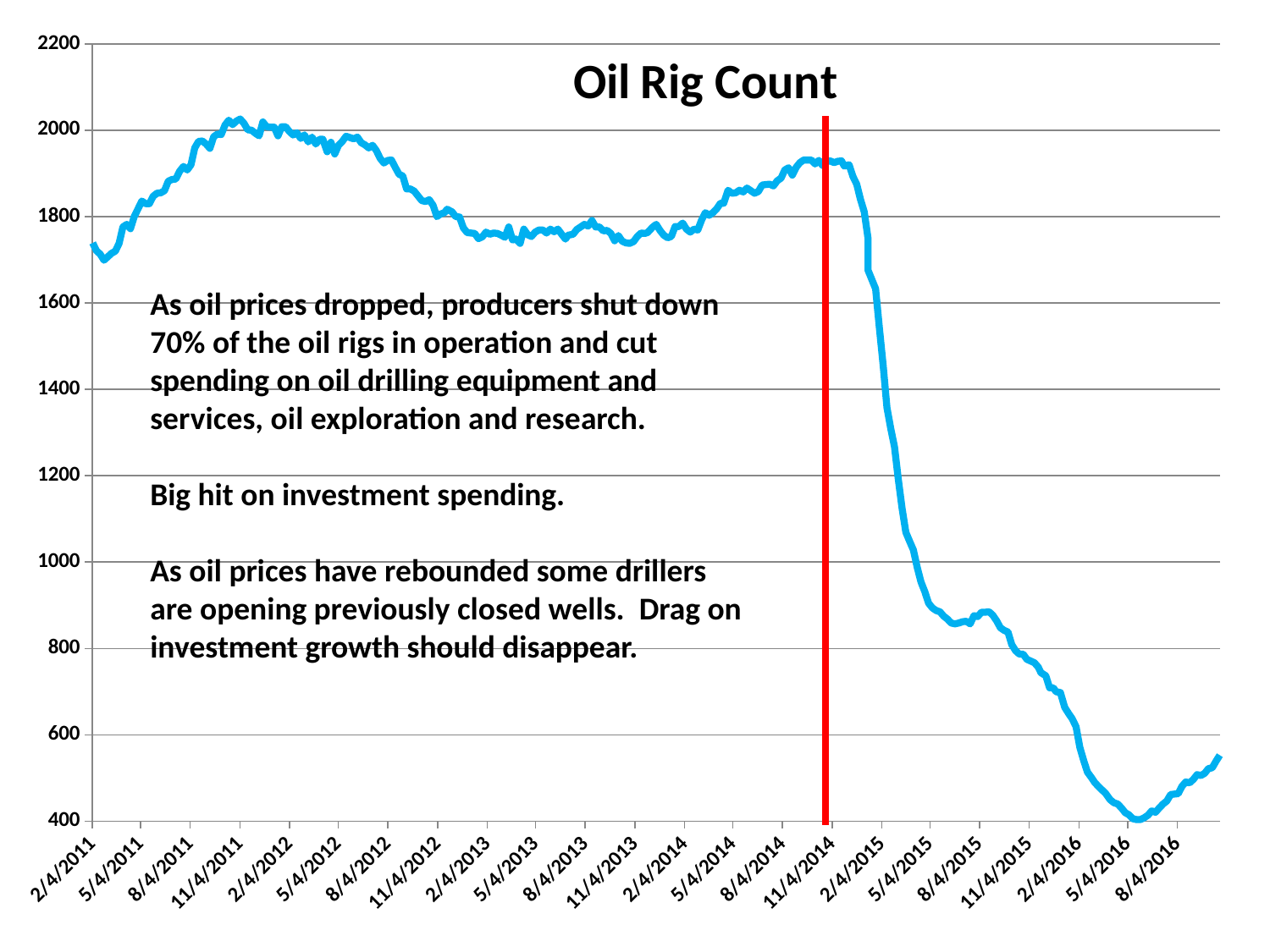
What is the title of the chart? Oil Rig Count Near which x-axis date is the red vertical line drawn? 11/4/2014 Is the oil rig count at 11/4/2011 greater or less than 1800? greater What kind of chart is shown on the slide? line chart Which is larger, the oil rig count at 11/4/2011 or at 11/4/2015? 11/4/2011 Is the oil rig count at 2/4/2016 greater or less than 800? less Is the oil rig count at 2/4/2013 greater or less than 1600? greater Does the oil rig count rise or fall between 5/4/2016 and 8/4/2016? rise In which year does the line reach its lowest point? 2016 Does the oil rig count rise or fall between 11/4/2014 and 5/4/2015? fall